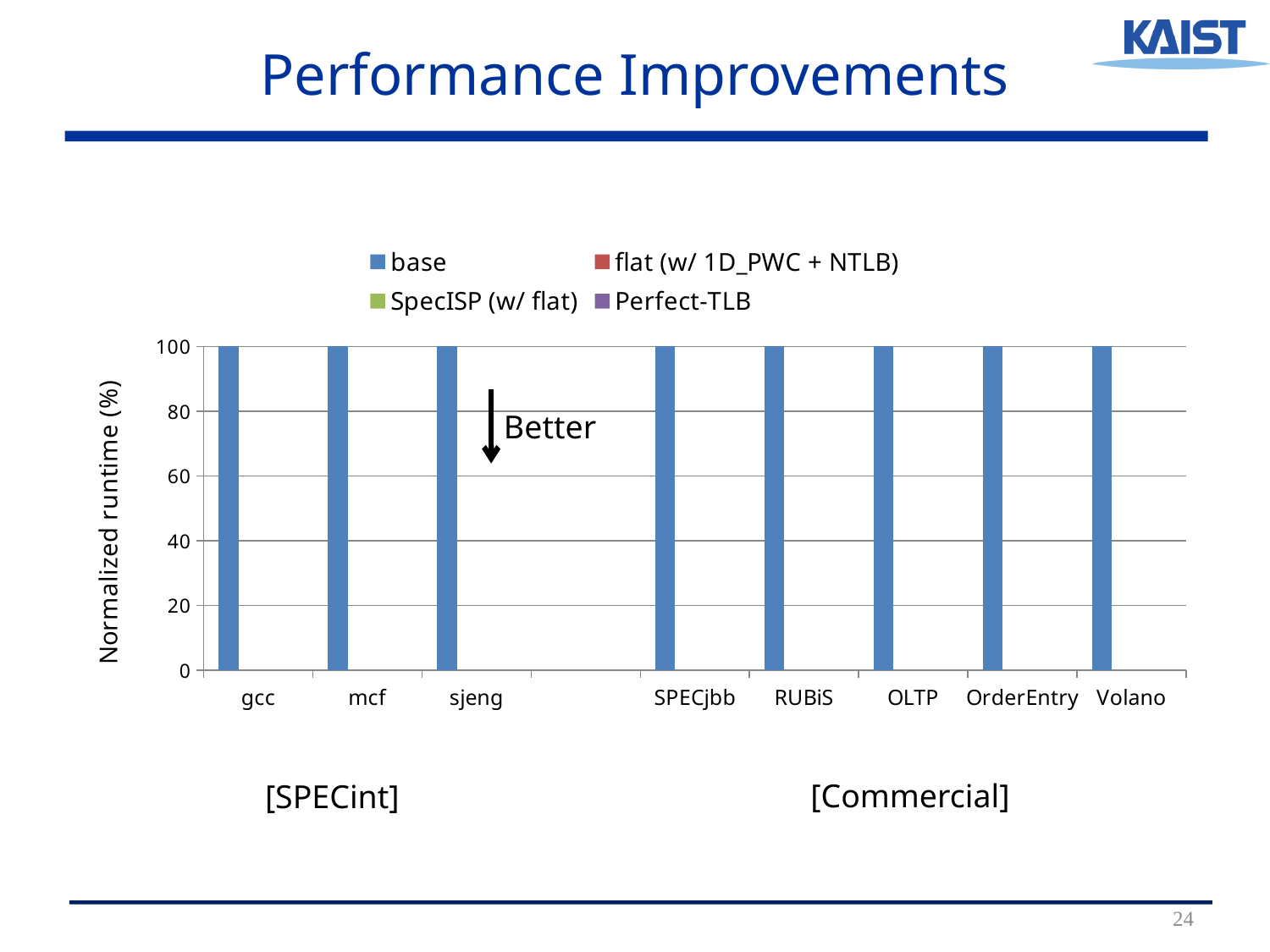
What is the title of the y axis? Normalized runtime (%) What is the difference between the base values for gcc and RUBiS? 0 What is the base normalized runtime for OLTP? 100 Which legend series is drawn in blue? base What is the base normalized runtime for gcc? 100 How many labeled categories are on the x axis? 8 Is the base value for SPECjbb greater or less than 60? greater What is the base normalized runtime for Volano? 100 Do the base values rise, fall, or stay the same across the categories on the x axis? stay the same What kind of chart is shown on the slide? bar chart How many series does the legend list? 4 Is the base value for mcf greater or less than 80? greater